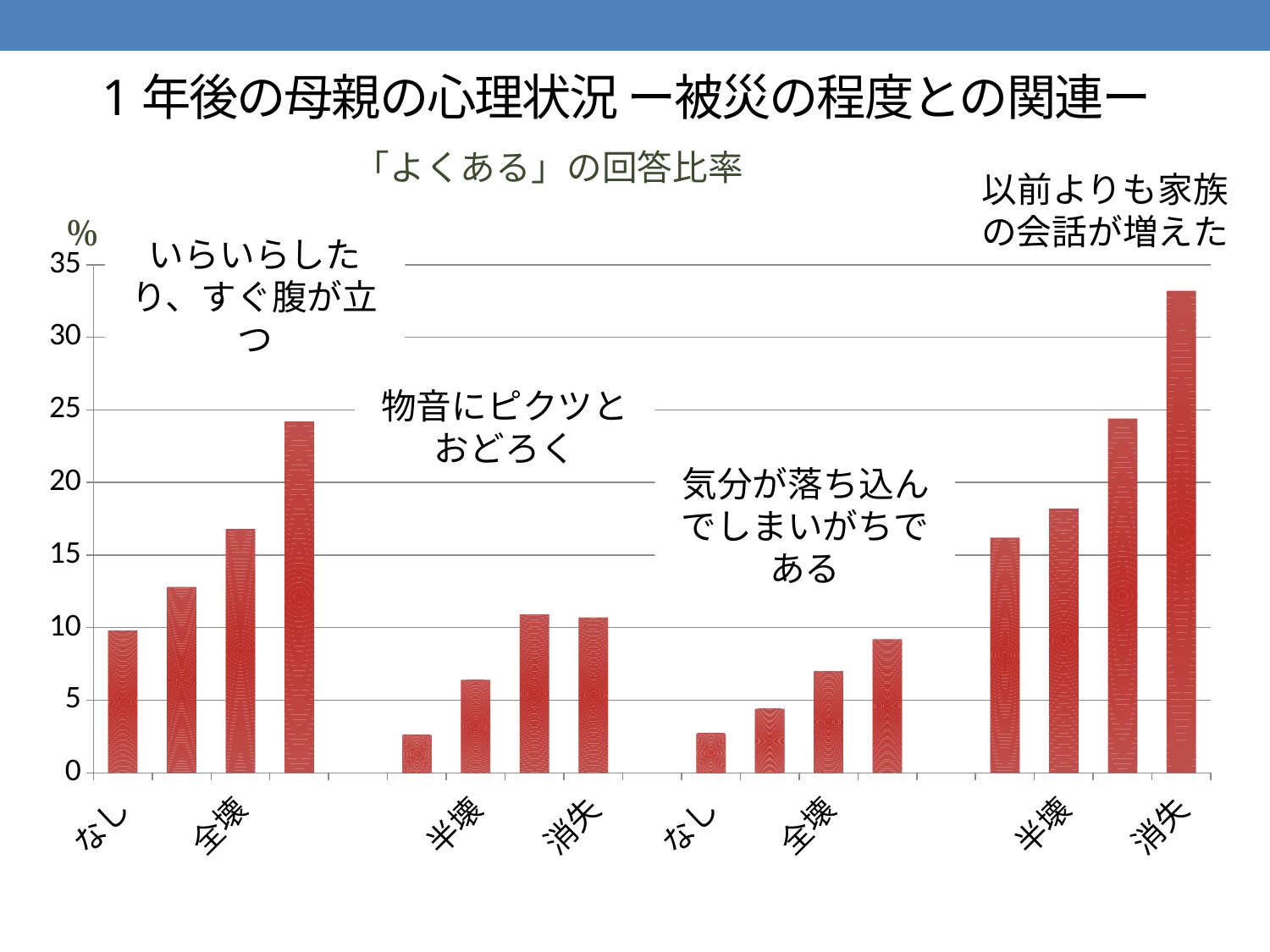
In the 以前よりも家族の会話が増えた group, is the value for 消失 greater or less than 30? greater How many groups of bars (psychological items) does the chart show? 4 How many bars are plotted in total on the chart? 16 In the 以前よりも家族の会話が増えた group, do the bars rise or fall from left to right? rise In the いらいらしたり、すぐ腹が立つ group, is the value for 全壊 greater or less than 15? greater In the いらいらしたり、すぐ腹が立つ group, which category has the lowest bar? なし In the 物音にピクツとおどろく group, is the value for 消失 greater or less than 15? less What unit is shown at the top of the vertical axis? % Which is larger: the 消失 bar in the いらいらしたり、すぐ腹が立つ group or the 消失 bar in the 以前よりも家族の会話が増えた group? 以前よりも家族の会話が増えた What kind of chart is shown on the slide? bar chart Which bar is the highest on the whole chart? 消失 in 以前よりも家族の会話が増えた